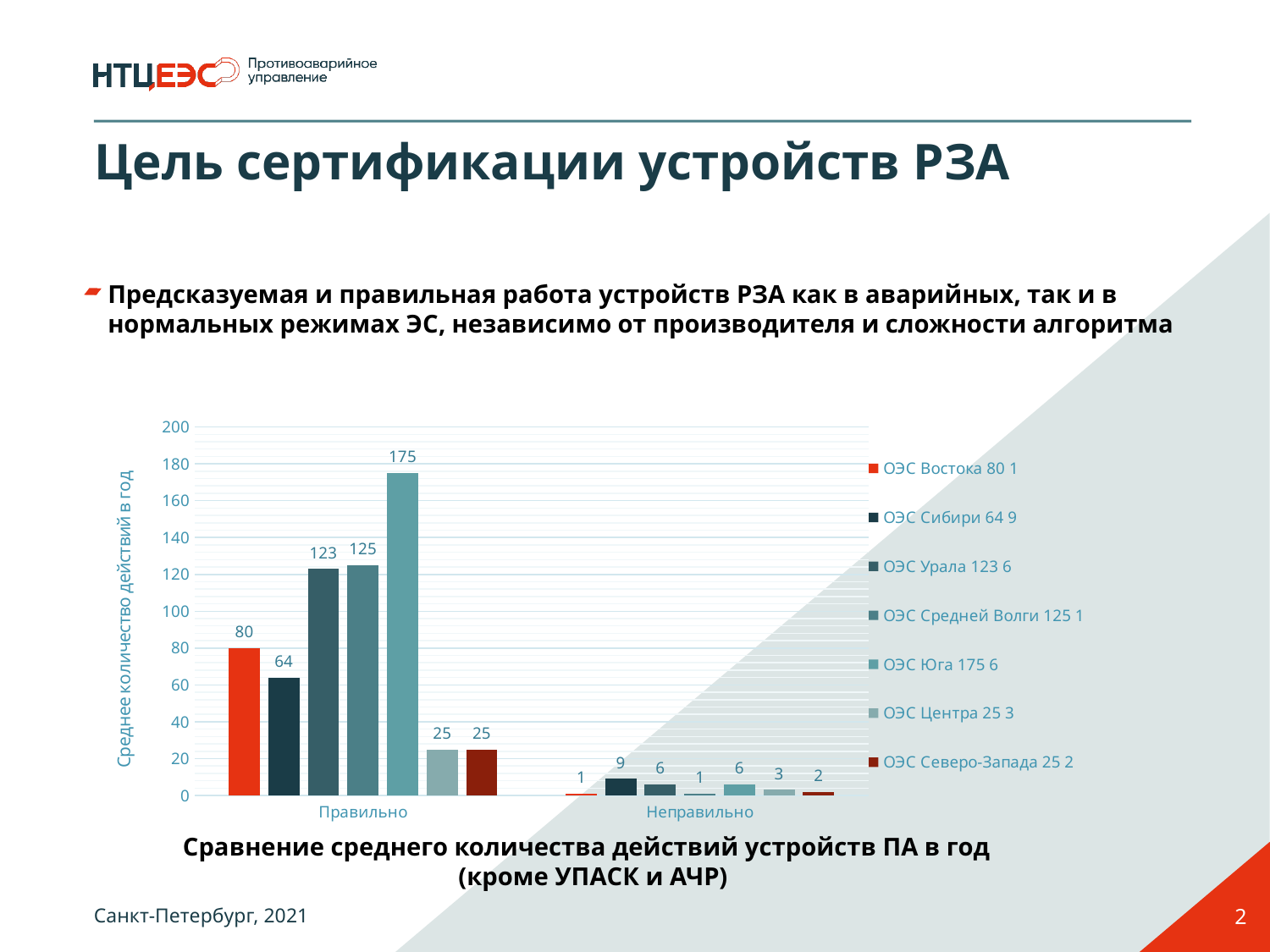
What kind of chart is shown on the slide? bar chart What is the value for ОЭС Сибири in the Неправильно category? 9 How many categories are shown on the x axis? 2 What is the value for ОЭС Центра in the Правильно category? 25 Which series has the highest value in the Неправильно category? ОЭС Сибири In the Правильно category, what is the difference between the values for ОЭС Юга and ОЭС Востока? 95 In the Неправильно category, what is the difference between the values for ОЭС Сибири and ОЭС Северо-Запада? 7 How many series does the legend list? 7 In the Правильно category, which is larger: the value for ОЭС Востока or for ОЭС Сибири? ОЭС Востока Which series has the highest value in the Правильно category? ОЭС Юга What is the value for ОЭС Юга in the Правильно category? 175 Is the value for ОЭС Юга in the Правильно category greater or less than 160? greater